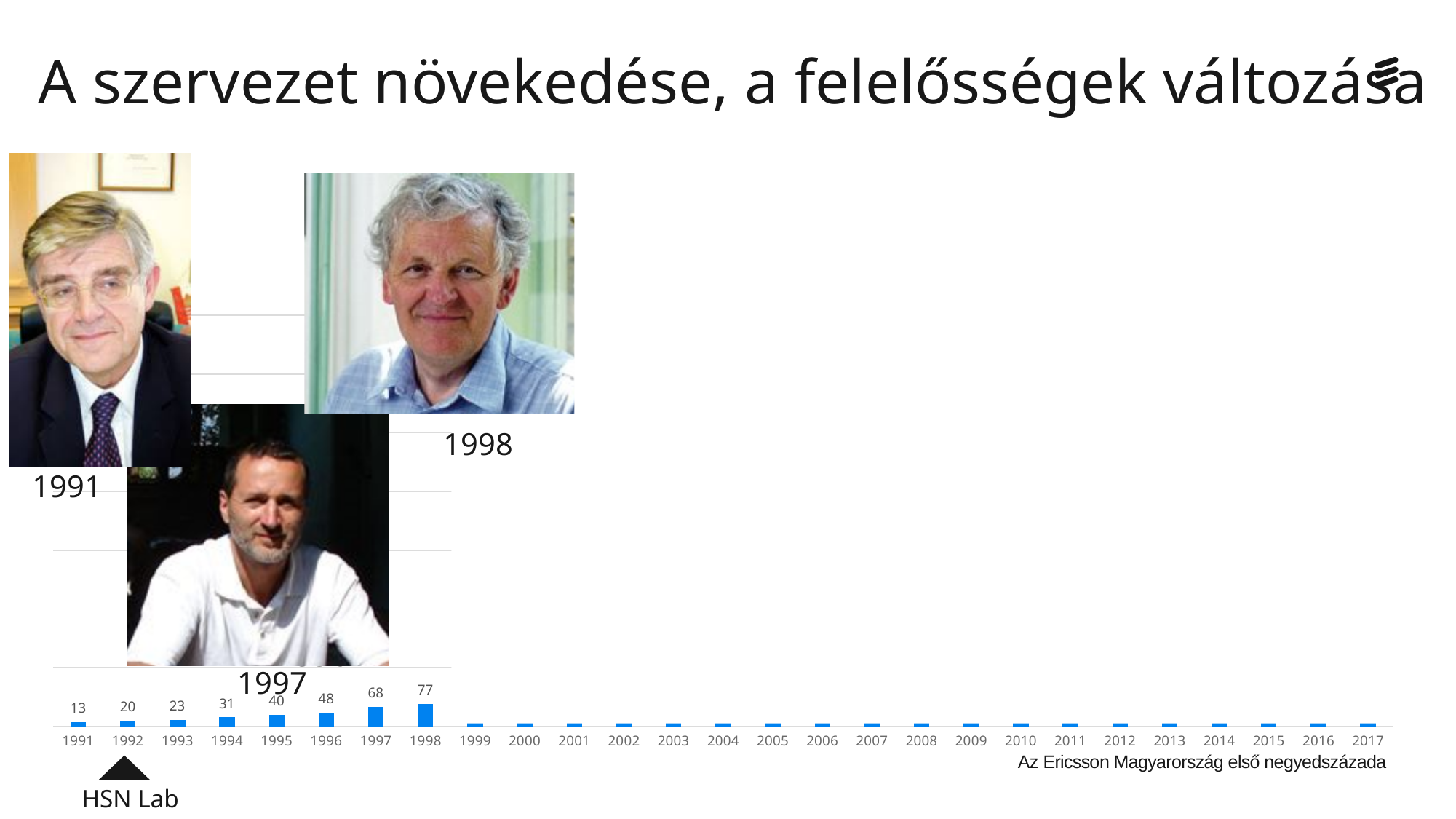
What is the value shown for 1997? 68 Among the bars with data labels (1991 to 1998), which year has the highest value? 1998 What kind of chart is shown on the slide? bar chart What is the difference between the values for 1998 and 1997? 9 Among the bars with data labels (1991 to 1998), which year has the lowest value? 1991 How many years are shown on the x axis of the chart? 27 What is the value shown for 1991? 13 What is the value shown for 1995? 40 Which is larger, the value for 1994 or the value for 1993? 1994 What is the difference between the values for 1996 and 1991? 35 Do the values rise or fall from 1991 to 1998? rise What is the value shown for 1998? 77